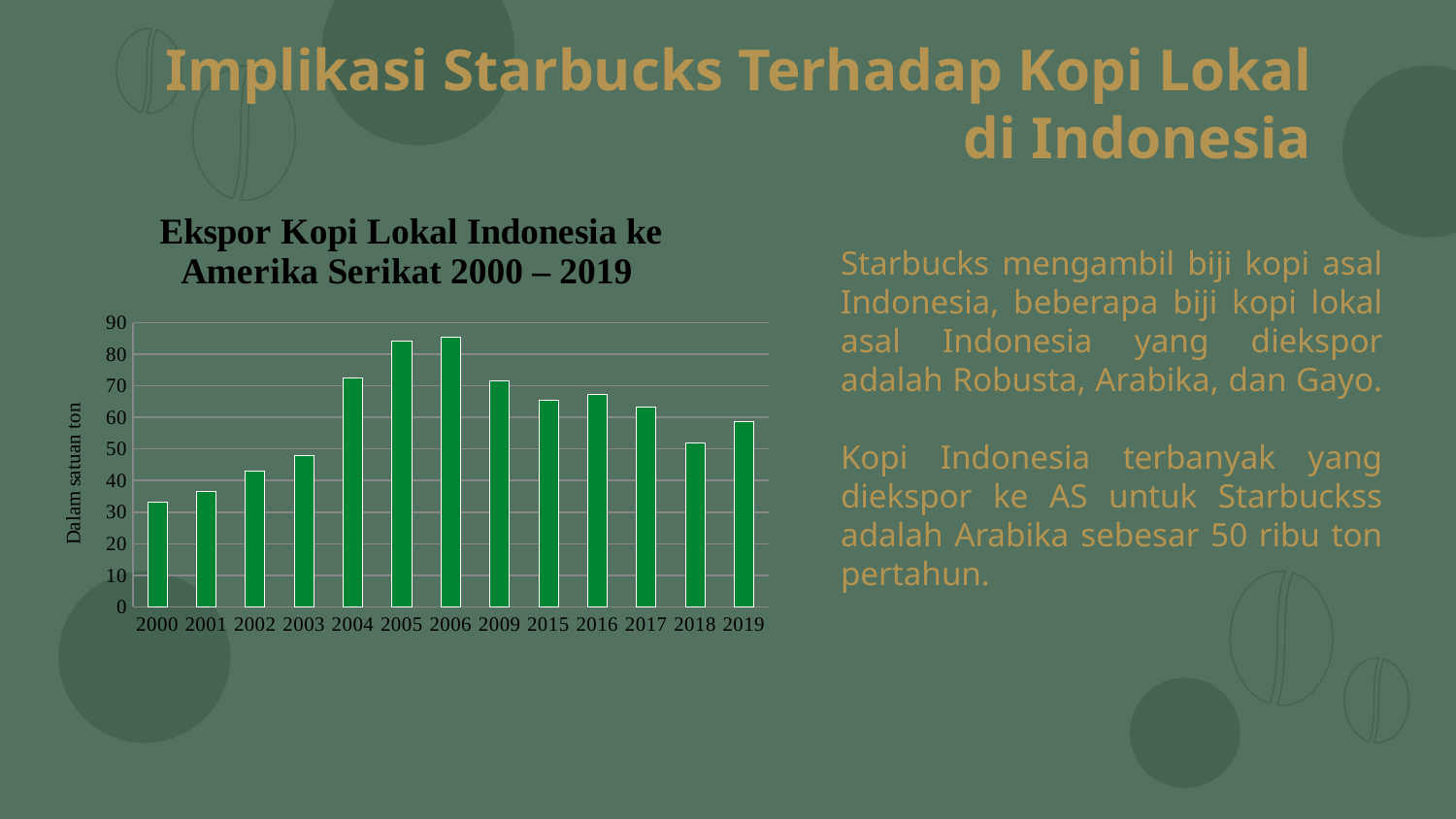
Is the value for 2018 greater or less than 60? less Is the value for 2000 greater or less than 40? less Is the value for 2015 greater or less than 70? less Which year has the larger value, 2018 or 2019? 2019 What kind of chart is shown on the slide? Bar chart Do the values rise or fall from 2000 to 2006? rise What is the label on the vertical axis of the chart? Dalam satuan ton Which year has the lowest export value in the chart? 2000 Which year has the larger value, 2003 or 2004? 2004 How many years (bars) are plotted in the chart? 13